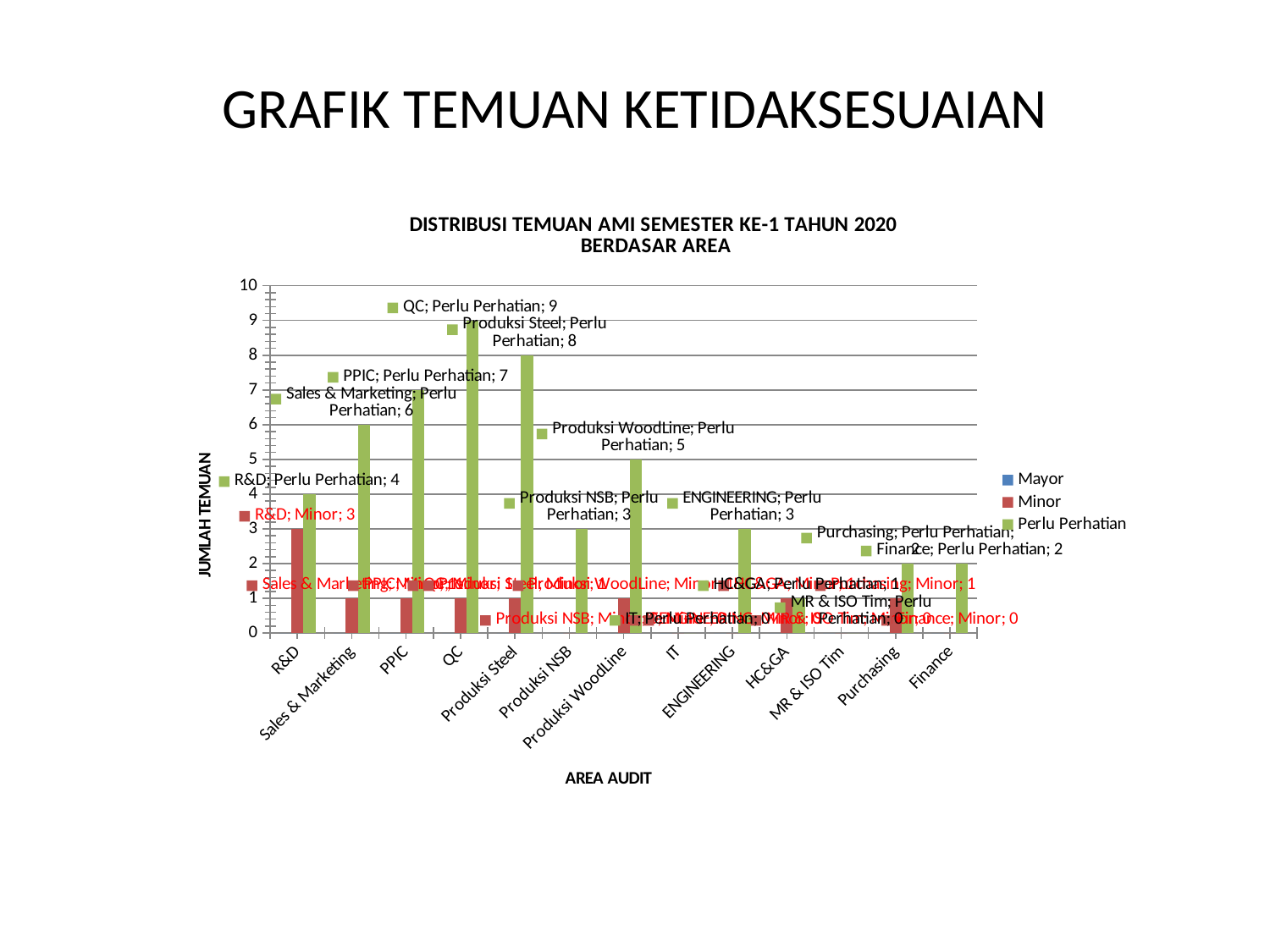
What is the Perlu Perhatian value for Produksi WoodLine? 5 What is the difference between the Perlu Perhatian values for QC and Produksi Steel? 1 Which has the larger Perlu Perhatian value, Produksi WoodLine or Produksi NSB? Produksi WoodLine What is the title of the vertical axis? JUMLAH TEMUAN Which audit area has the highest Perlu Perhatian value? QC What is the Minor value for R&D? 3 How many series does the legend list? 3 What is the Perlu Perhatian value for QC? 9 What is the Perlu Perhatian value for Produksi Steel? 8 What kind of chart is shown on the slide? bar chart How many audit areas are shown on the x axis? 13 Is the Minor value for PPIC greater or less than 2? less